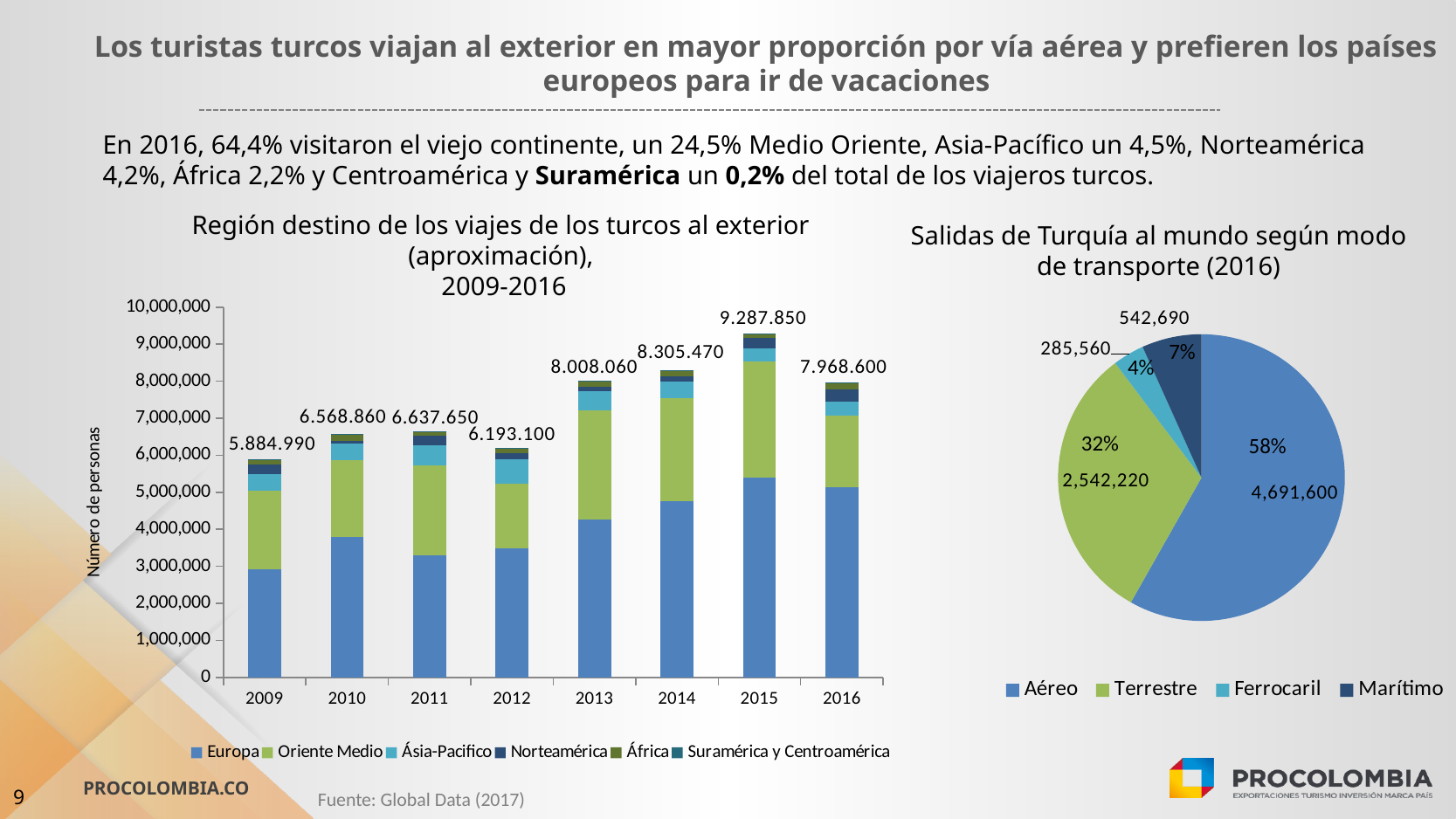
What kind of chart is the left chart 'Región destino de los viajes de los turcos al exterior'? Stacked bar chart In the bar chart 'Región destino de los viajes de los turcos al exterior', which year has the larger total, 2010 or 2011? 2011 In the bar chart 'Región destino de los viajes de los turcos al exterior', which year has the highest total? 2015 How many years are shown on the x axis of the bar chart 'Región destino de los viajes de los turcos al exterior'? 8 In the bar chart 'Región destino de los viajes de los turcos al exterior', what is the total labeled for 2015? 9.287.850 In the bar chart 'Región destino de los viajes de los turcos al exterior', what is the difference between the 2015 total and the 2016 total? 1.319.250 How many series does the legend of the bar chart 'Región destino de los viajes de los turcos al exterior' list? 6 In the bar chart 'Región destino de los viajes de los turcos al exterior', is the Europa value for 2015 greater or less than 5,000,000? greater In the bar chart 'Región destino de los viajes de los turcos al exterior', which year has the lowest total? 2009 In the pie chart 'Salidas de Turquía al mundo según modo de transporte (2016)', what share does Terrestre have? 32% In the pie chart 'Salidas de Turquía al mundo según modo de transporte (2016)', which mode of transport has the smallest slice? Ferrocaril In the pie chart 'Salidas de Turquía al mundo según modo de transporte (2016)', what is the value for Aéreo? 4,691,600